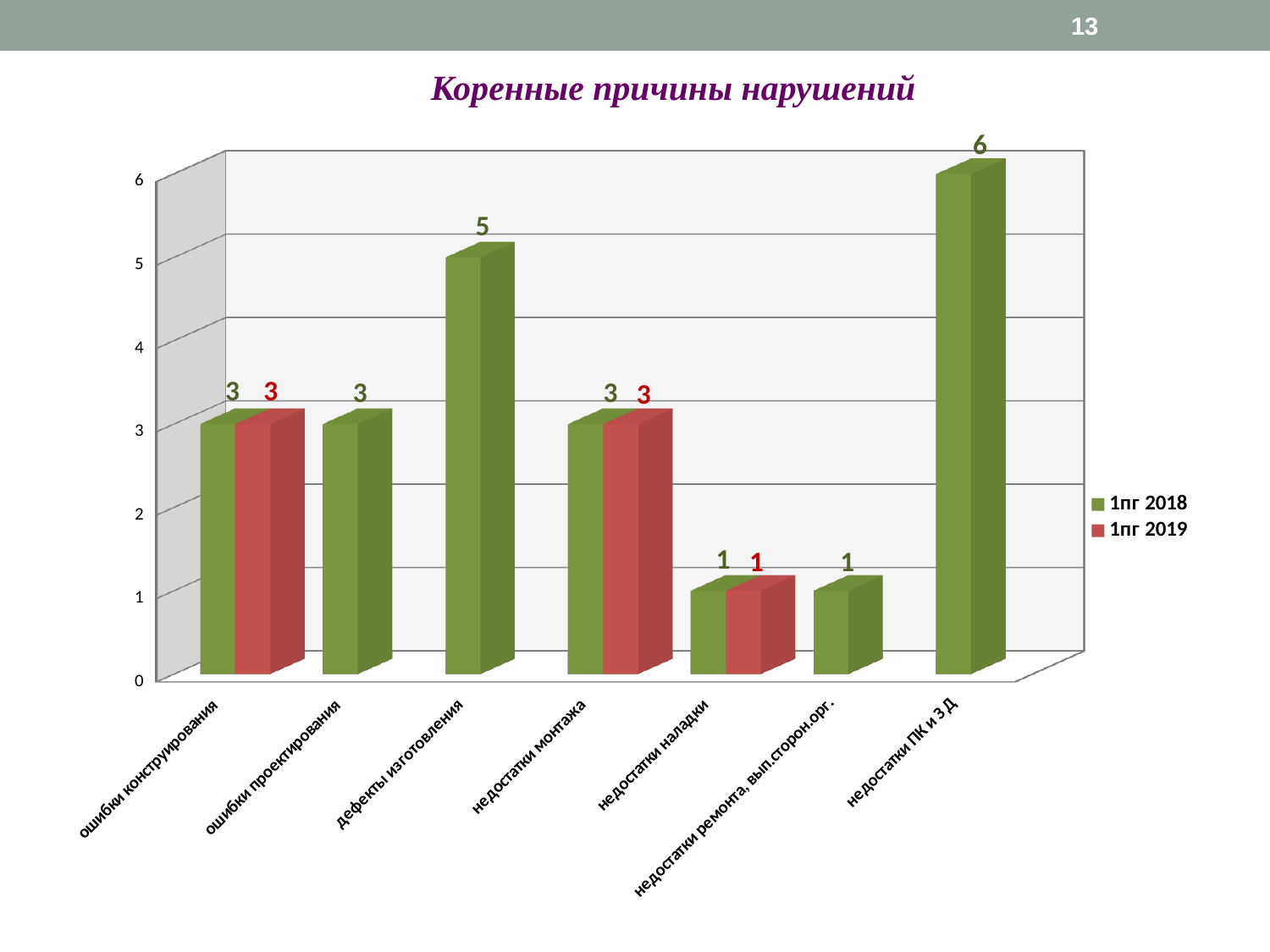
What is the value for 1пг 2018 for дефекты изготовления? 5 What is the title of the chart? Коренные причины нарушений How many series does the legend list? 2 What is the difference between the 1пг 2018 values for недостатки ПК и З Д and дефекты изготовления? 1 What kind of chart is shown on the slide? bar chart Which category has the highest value for 1пг 2018? недостатки ПК и З Д What is the value for 1пг 2018 for недостатки ПК и З Д? 6 How many categories are shown on the x axis? 7 Which is larger for 1пг 2018: дефекты изготовления or ошибки проектирования? дефекты изготовления What is the value for 1пг 2019 for недостатки монтажа? 3 Which colour represents the 1пг 2019 series? red What is the value for 1пг 2019 for недостатки наладки? 1